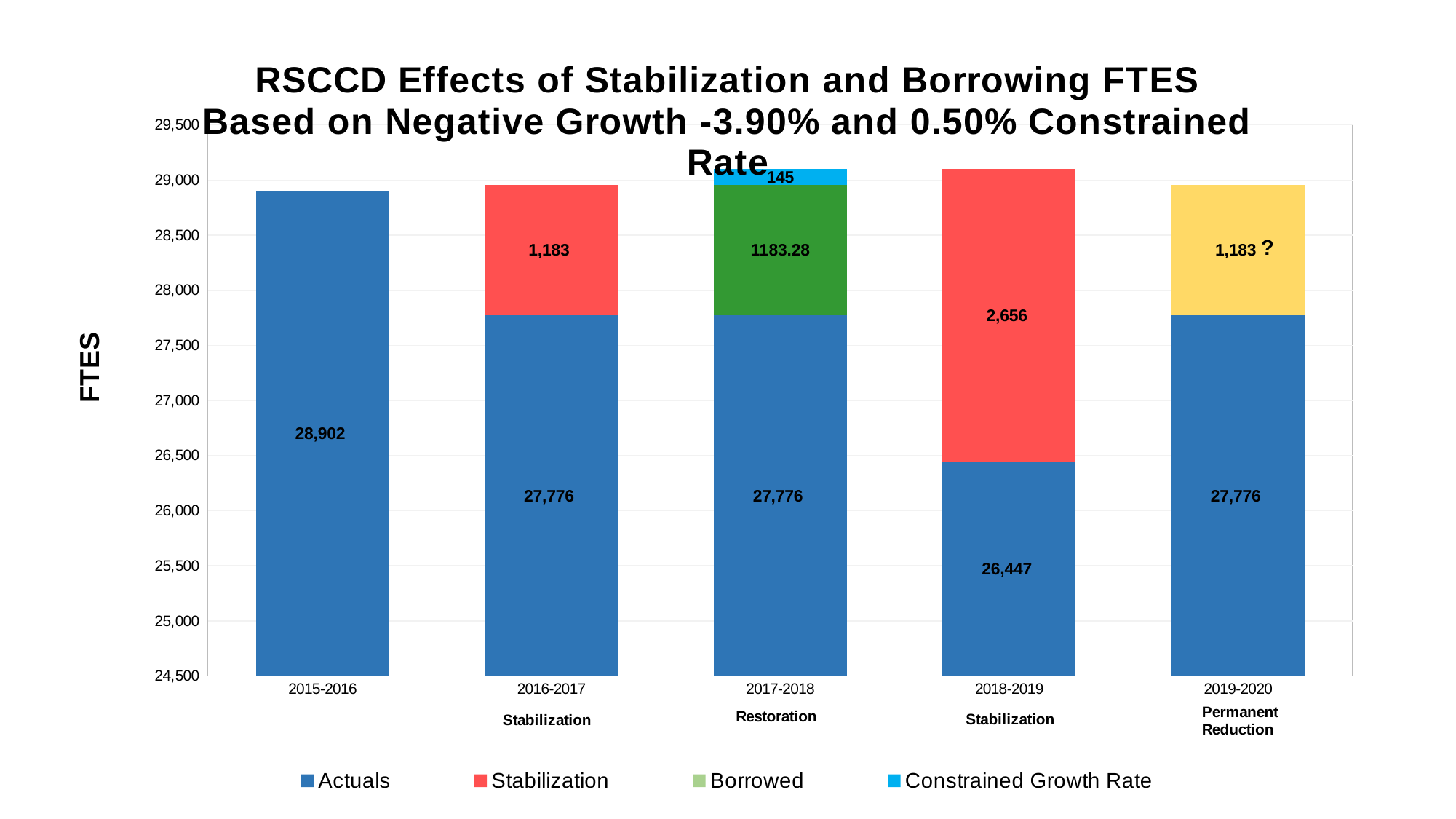
What is the Actuals value for 2015-2016? 28,902 What is the total of the stacked bar for 2018-2019? 29,103 Which year has the lowest Actuals value? 2018-2019 What is the Borrowed value for 2017-2018? 1183.28 How many years are shown on the x axis? 5 What is the Stabilization value for 2018-2019? 2,656 How many series does the legend list? 4 What is the Constrained Growth Rate value for 2017-2018? 145 What is the difference between the Actuals value for 2015-2016 and the Actuals value for 2016-2017? 1,126 Which year has the highest Actuals value? 2015-2016 What is the Actuals value for 2018-2019? 26,447 Which year has the larger Stabilization value, 2016-2017 or 2018-2019? 2018-2019